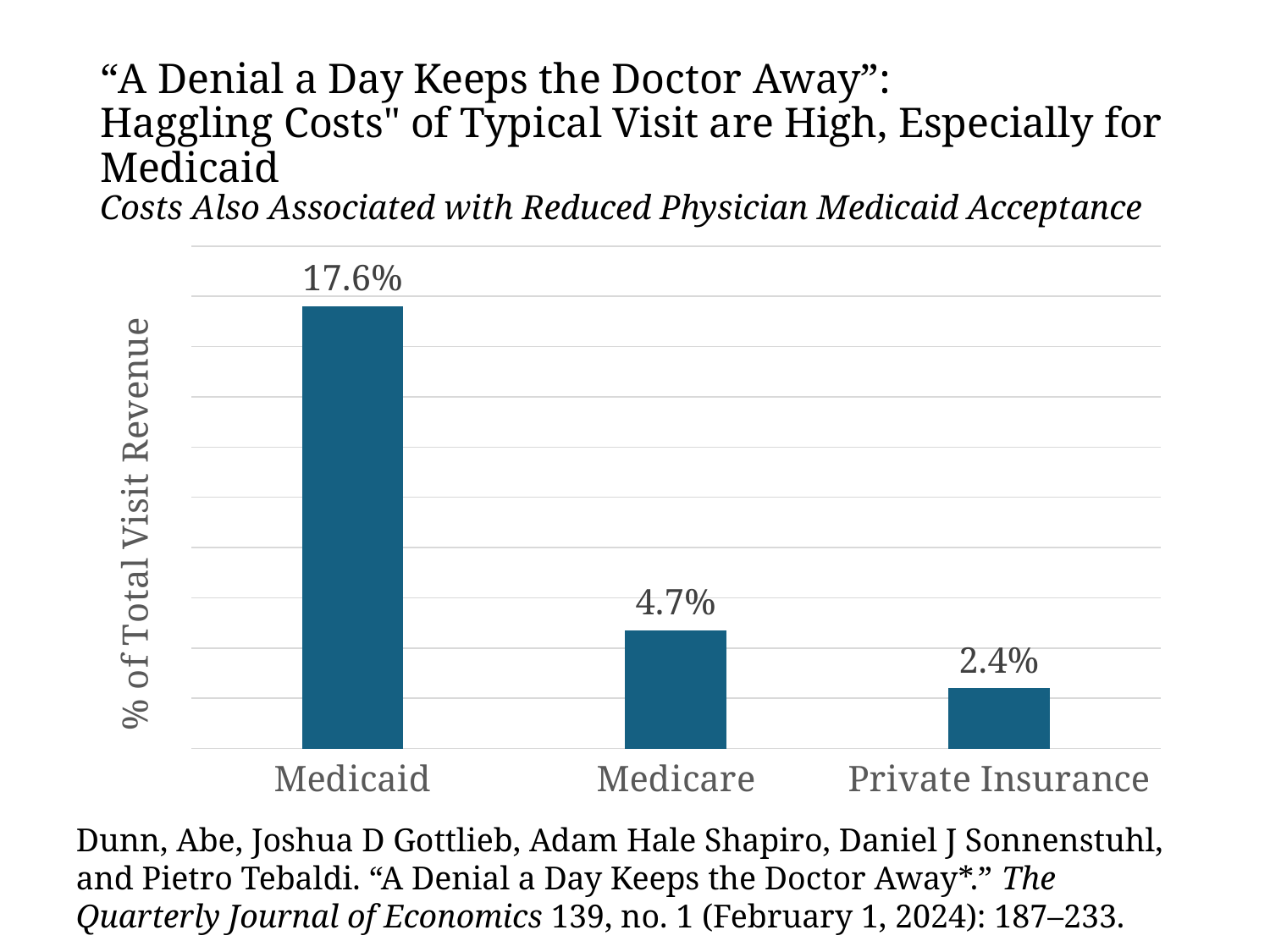
Which category has the lowest value? Private Insurance Do the values rise or fall from left to right across the categories? Fall What is the difference between the values for Medicare and Private Insurance? 2.3% What is the value for Medicaid? 17.6% Which is larger, the value for Medicare or the value for Private Insurance? Medicare What is the value for Medicare? 4.7% What is the value for Private Insurance? 2.4% What is the difference between the values for Medicaid and Medicare? 12.9% Which category has the highest value? Medicaid What kind of chart is shown on the slide? Bar chart How many categories are shown in the chart? 3 What is the label of the vertical axis? % of Total Visit Revenue